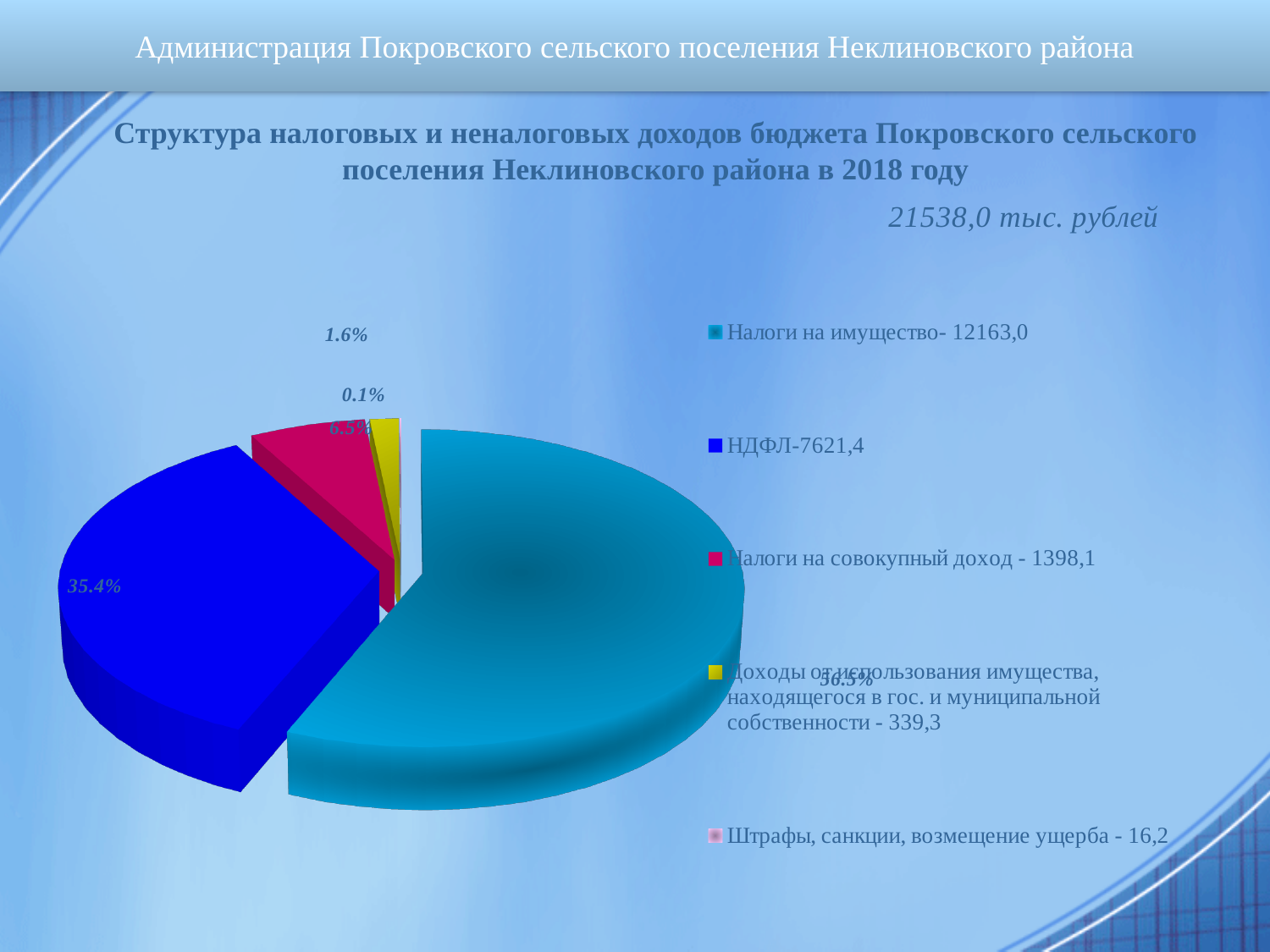
Which is larger: НДФЛ or Налоги на совокупный доход? НДФЛ Which category has the smallest value in the pie chart? Штрафы, санкции, возмещение ущерба What value is given in the legend for Штрафы, санкции, возмещение ущерба? 16,2 What kind of chart is shown on the slide? pie chart What is the difference between the values for Налоги на имущество and НДФЛ? 4541,6 How many categories does the pie chart's legend list? 5 What value is given in the legend for НДФЛ? 7621,4 What value is given in the legend for Налоги на совокупный доход? 1398,1 What value is given in the legend for Налоги на имущество? 12163,0 What share of the pie does the НДФЛ slice represent? 35.4% Which category has the largest value in the pie chart? Налоги на имущество What total amount in thousand rubles is stated above the chart? 21538,0 тыс. рублей